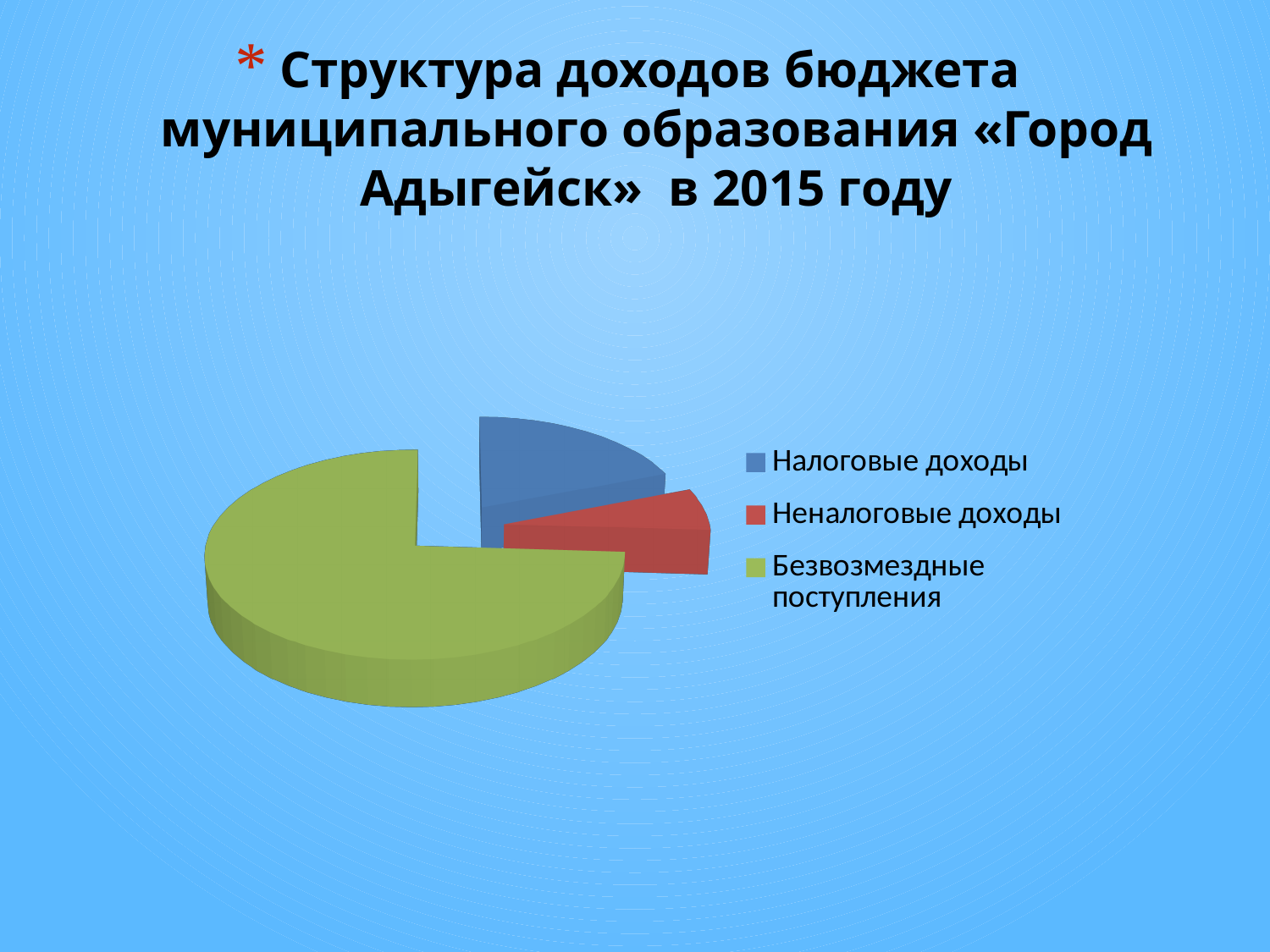
Which slice is larger: Безвозмездные поступления or Налоговые доходы? Безвозмездные поступления Which category has the largest slice of the pie chart? Безвозмездные поступления Which category has the smallest slice of the pie chart? Неналоговые доходы What colour is the slice for Налоговые доходы? Blue How many entries does the legend of the pie chart list? 3 Which slice is larger: Налоговые доходы or Неналоговые доходы? Налоговые доходы How many slices does the pie chart have? 3 What colour is the slice for Безвозмездные поступления? Green What kind of chart is shown on the slide? Pie chart